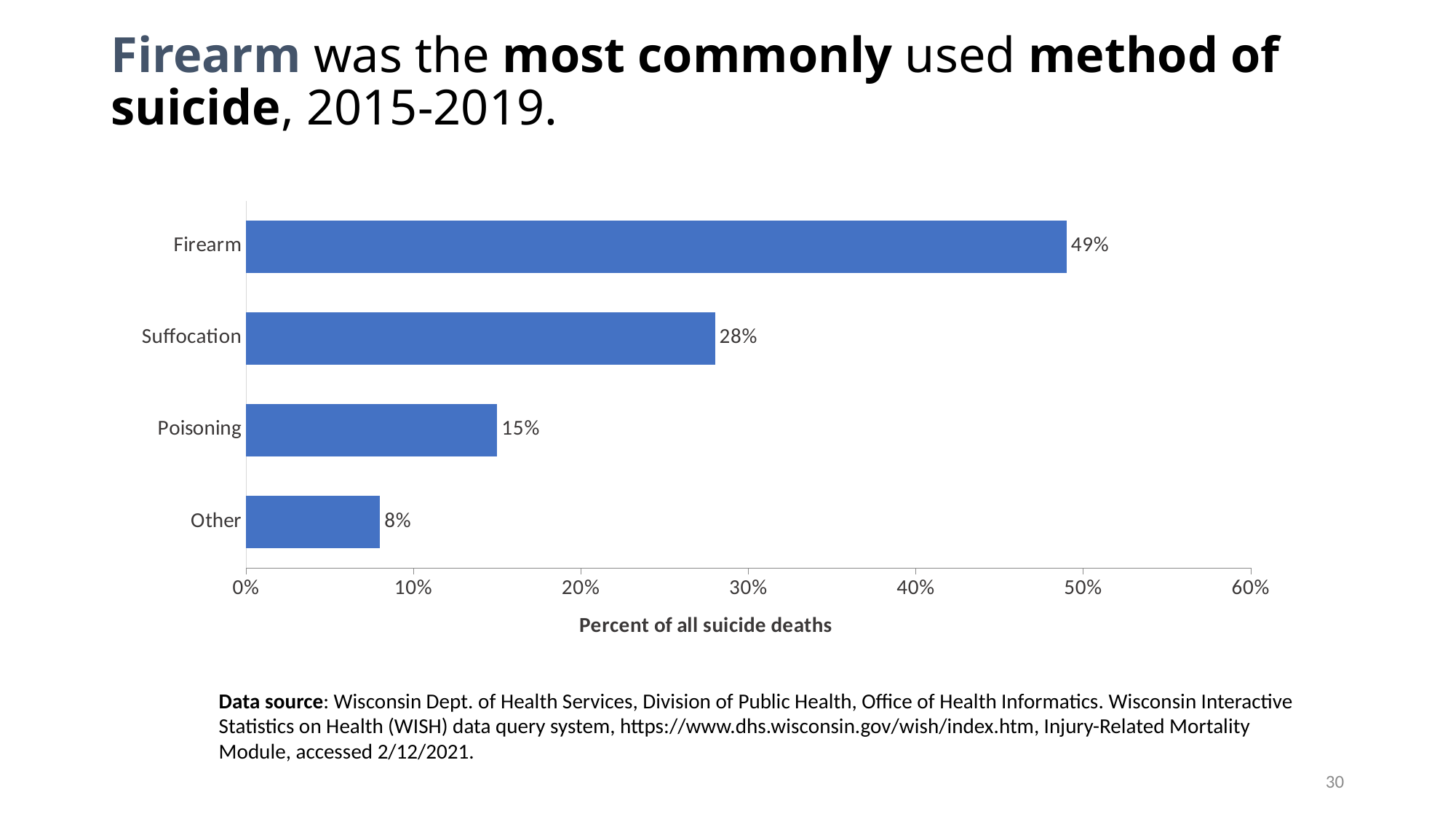
What is the difference in percentage points between Firearm and Suffocation? 21 Is the value for Suffocation greater or less than 30%? less What is the label of the horizontal axis? Percent of all suicide deaths What is the value shown for the Other category? 8% What kind of chart is shown on the slide? Bar chart What is the value shown for Suffocation? 28% What percent of all suicide deaths were by firearm? 49% Which category has the lowest value on the chart? Other What percent of all suicide deaths were by poisoning? 15% Which is larger, the value for Poisoning or the value for Other? Poisoning How many categories are shown on the chart? 4 Which method of suicide has the highest percent of all suicide deaths? Firearm